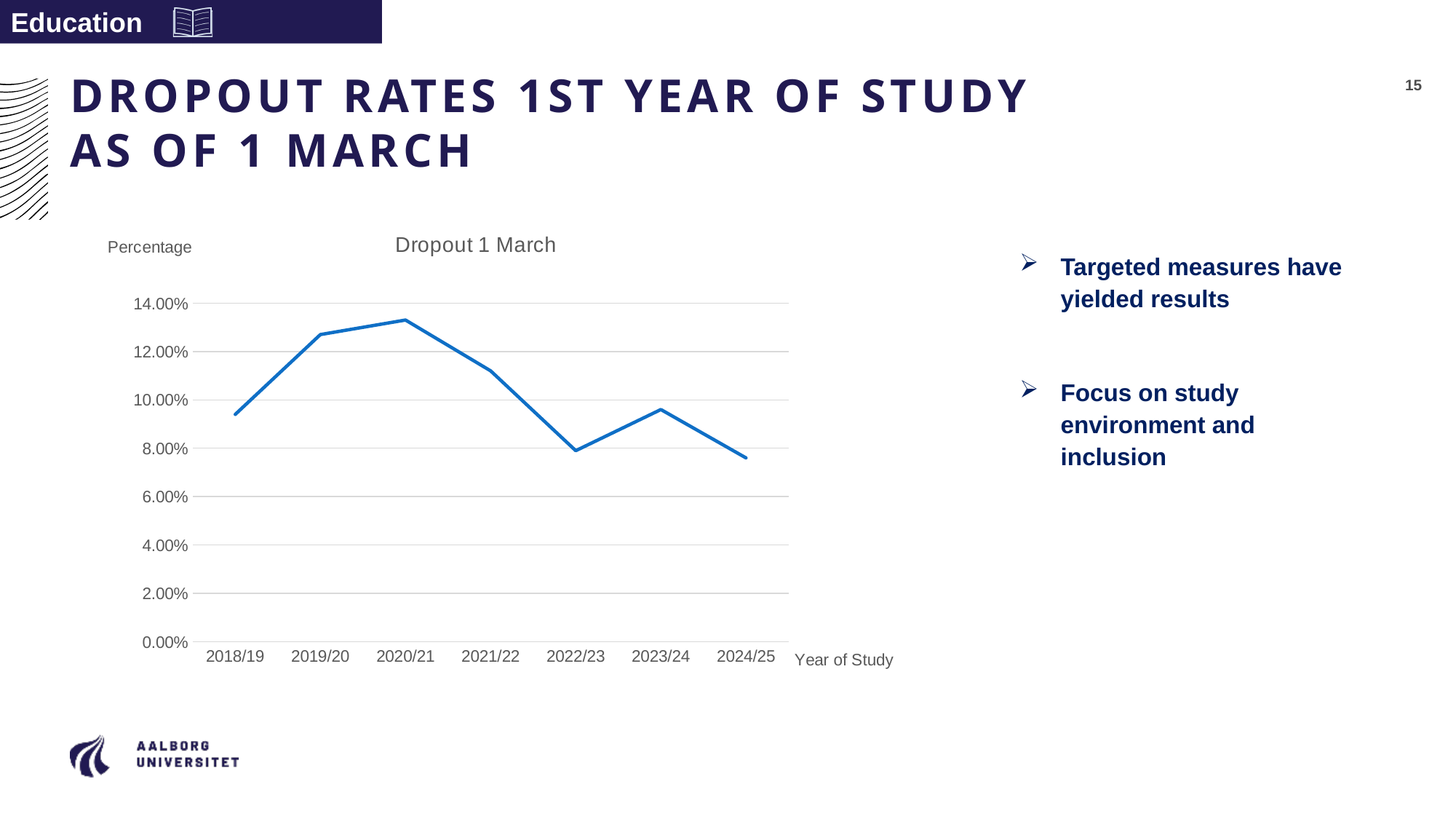
Does the dropout rate rise or fall from 2020/21 to 2022/23? fall What is the label of the x axis? Year of Study Which has a higher dropout rate, 2021/22 or 2023/24? 2021/22 How many years of study are plotted on the x axis? 7 Is the dropout rate for 2024/25 greater or less than 8.00%? less What kind of chart is shown on the slide? line chart Is the dropout rate for 2020/21 greater or less than 12.00%? greater Is the dropout rate for 2019/20 greater or less than 12.00%? greater Which year of study has the highest dropout rate? 2020/21 What is the title of the chart? Dropout 1 March